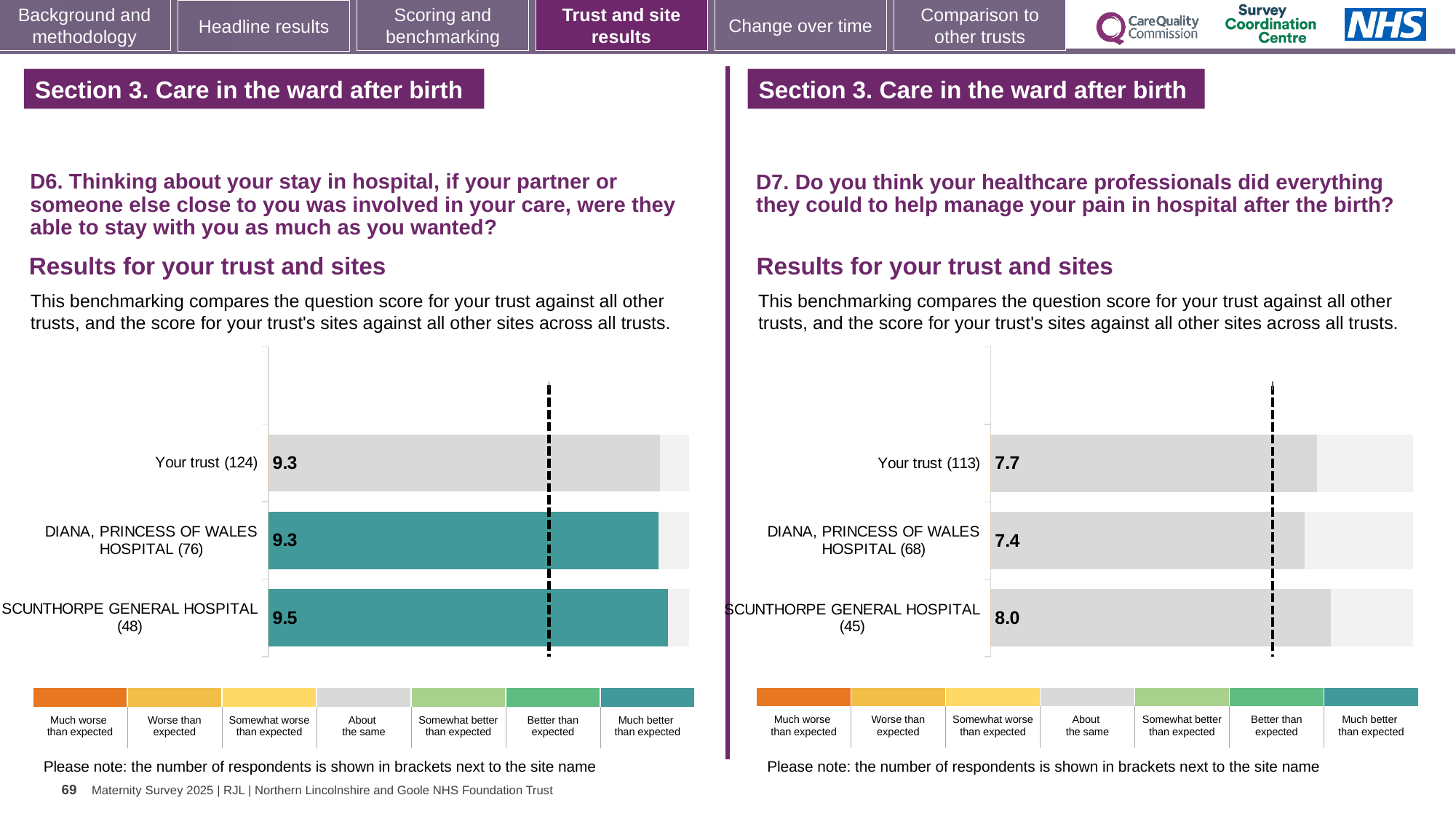
How many bars are plotted in the D7 chart on the right? 3 In the D6 chart on the left, what is the score for Scunthorpe General Hospital? 9.5 In the D7 chart on the right, what is the score for Diana, Princess of Wales Hospital? 7.4 In the D7 chart on the right, what is the difference between the scores for Scunthorpe General Hospital and Your trust? 0.3 In the D6 chart on the left, how many respondents are shown for Diana, Princess of Wales Hospital? 76 In the D6 chart on the left, which site or trust has the highest score? Scunthorpe General Hospital In the D7 chart on the right, which has the larger score, Scunthorpe General Hospital or Your trust? Scunthorpe General Hospital In the D6 chart on the left, what is the score for Your trust? 9.3 In the D7 chart on the right, which site or trust has the lowest score? Diana, Princess of Wales Hospital In the D6 chart on the left, what is the difference between the scores for Scunthorpe General Hospital and Diana, Princess of Wales Hospital? 0.2 In the D7 chart on the right, what is the score for Your trust? 7.7 What type of chart is used for the D6 results on the left? Bar chart